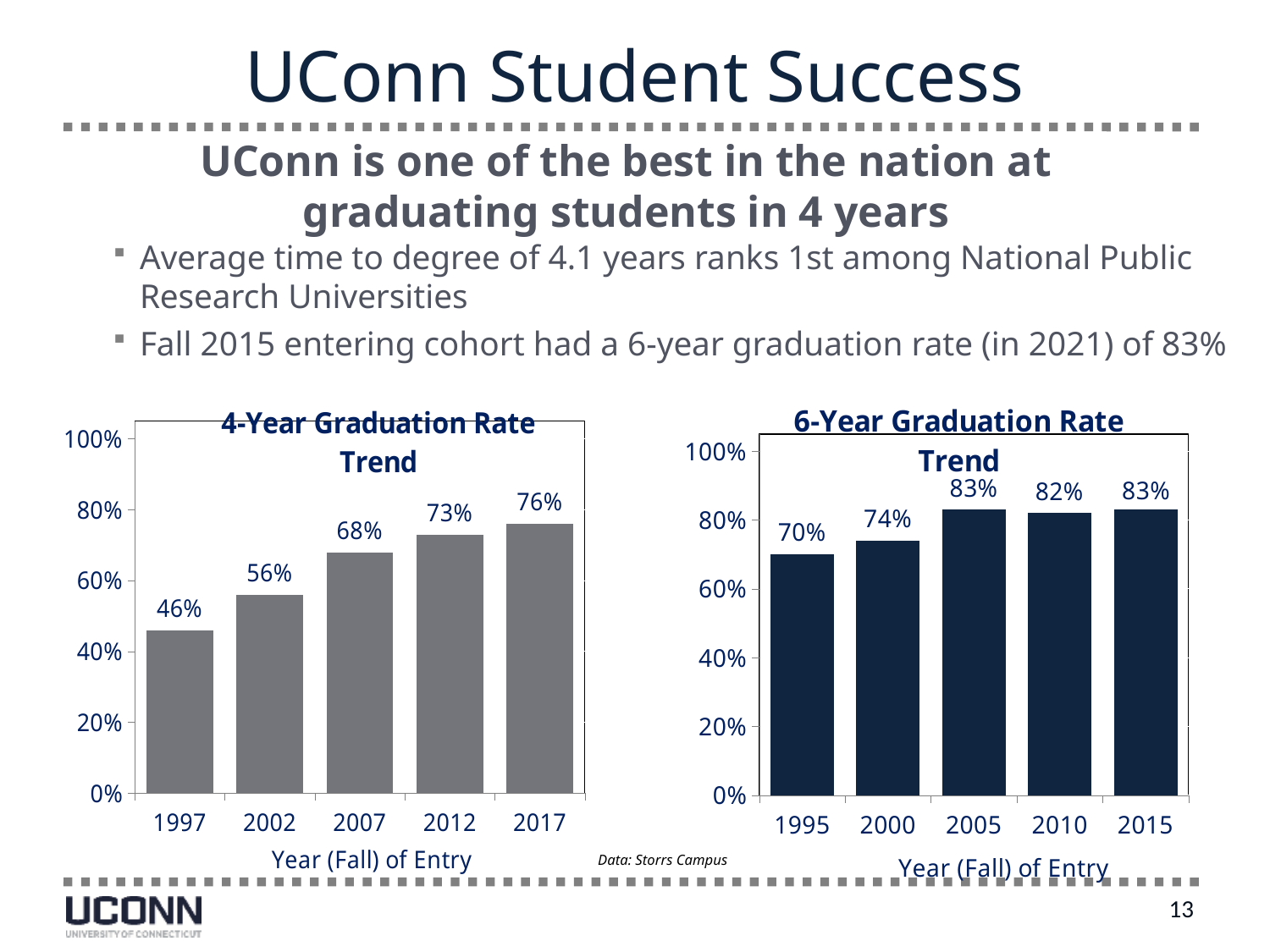
In the 6-Year Graduation Rate Trend chart, what is the difference between the values for 2005 and 1995? 13% In the 4-Year Graduation Rate Trend chart, do the values rise or fall from 1997 to 2017? rise In the 6-Year Graduation Rate Trend chart, which year has the lowest value? 1995 In the 6-Year Graduation Rate Trend chart, what is the value for 2000? 74% In the 4-Year Graduation Rate Trend chart, which is larger, the value for 2002 or the value for 2007? 2007 In the 4-Year Graduation Rate Trend chart, which year has the highest value? 2017 How many years are shown in the 4-Year Graduation Rate Trend chart? 5 What is the x-axis label of the 6-Year Graduation Rate Trend chart? Year (Fall) of Entry In the 4-Year Graduation Rate Trend chart, what is the difference between the values for 2017 and 1997? 30% In the 4-Year Graduation Rate Trend chart, what is the value for 1997? 46% What kind of chart is the 6-Year Graduation Rate Trend chart? bar chart In the 6-Year Graduation Rate Trend chart, is the value for 1995 greater or less than 60%? greater